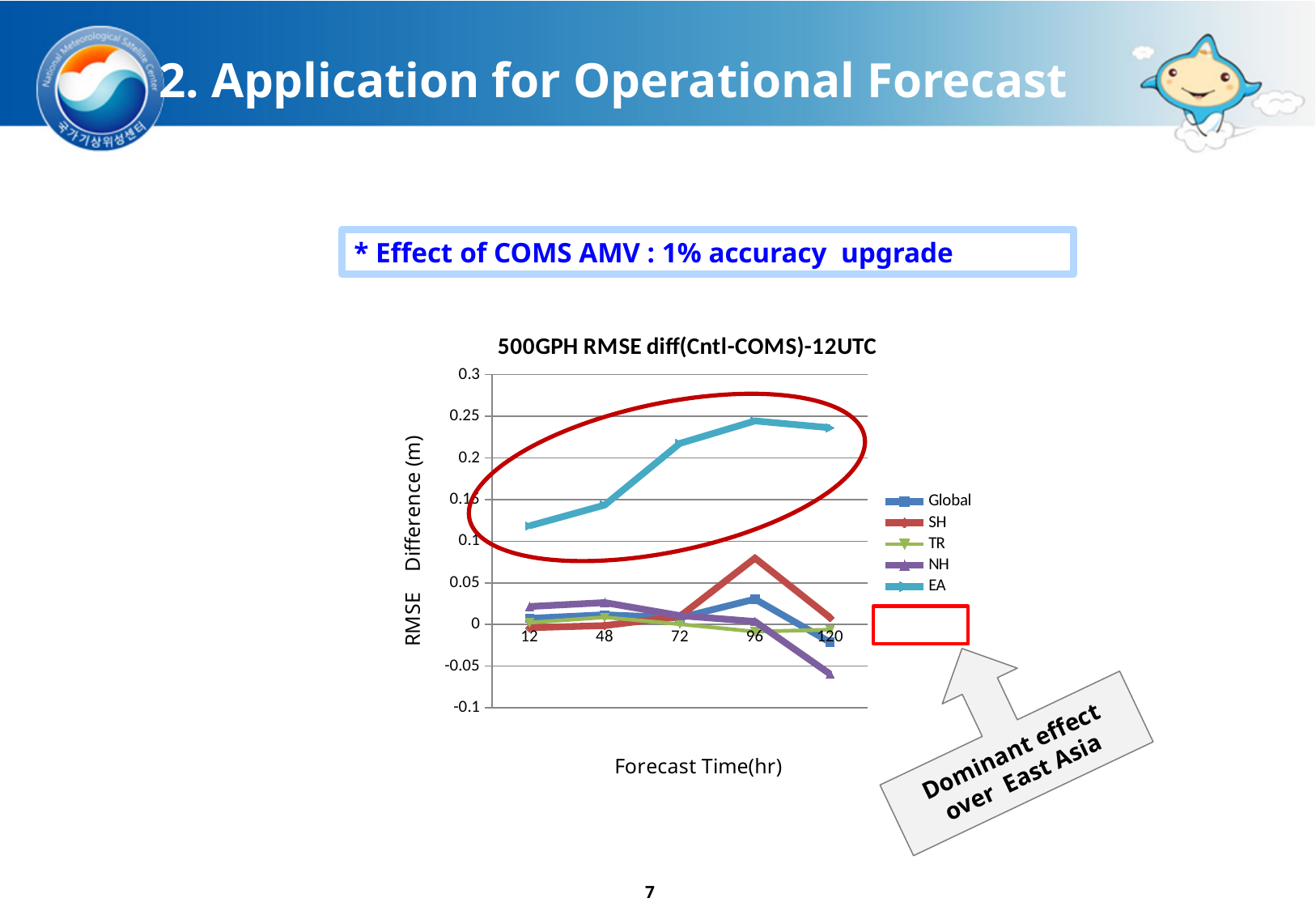
Does the EA series rise or fall from forecast time 12 to 96? rise How many forecast time points are plotted along the x axis? 5 Which series has the highest RMSE difference at forecast time 96? EA Which series has the lowest RMSE difference at forecast time 120? NH Which is larger at forecast time 96, the value for EA or the value for SH? EA Is the value for EA at forecast time 96 greater or less than 0.2? greater What is the title of the chart? 500GPH RMSE diff(Cntl-COMS)-12UTC Is the value for SH at forecast time 96 greater or less than 0.05? greater How many series does the legend list? 5 Is the value for NH at forecast time 120 greater or less than 0? less What kind of chart is shown on the slide? line chart